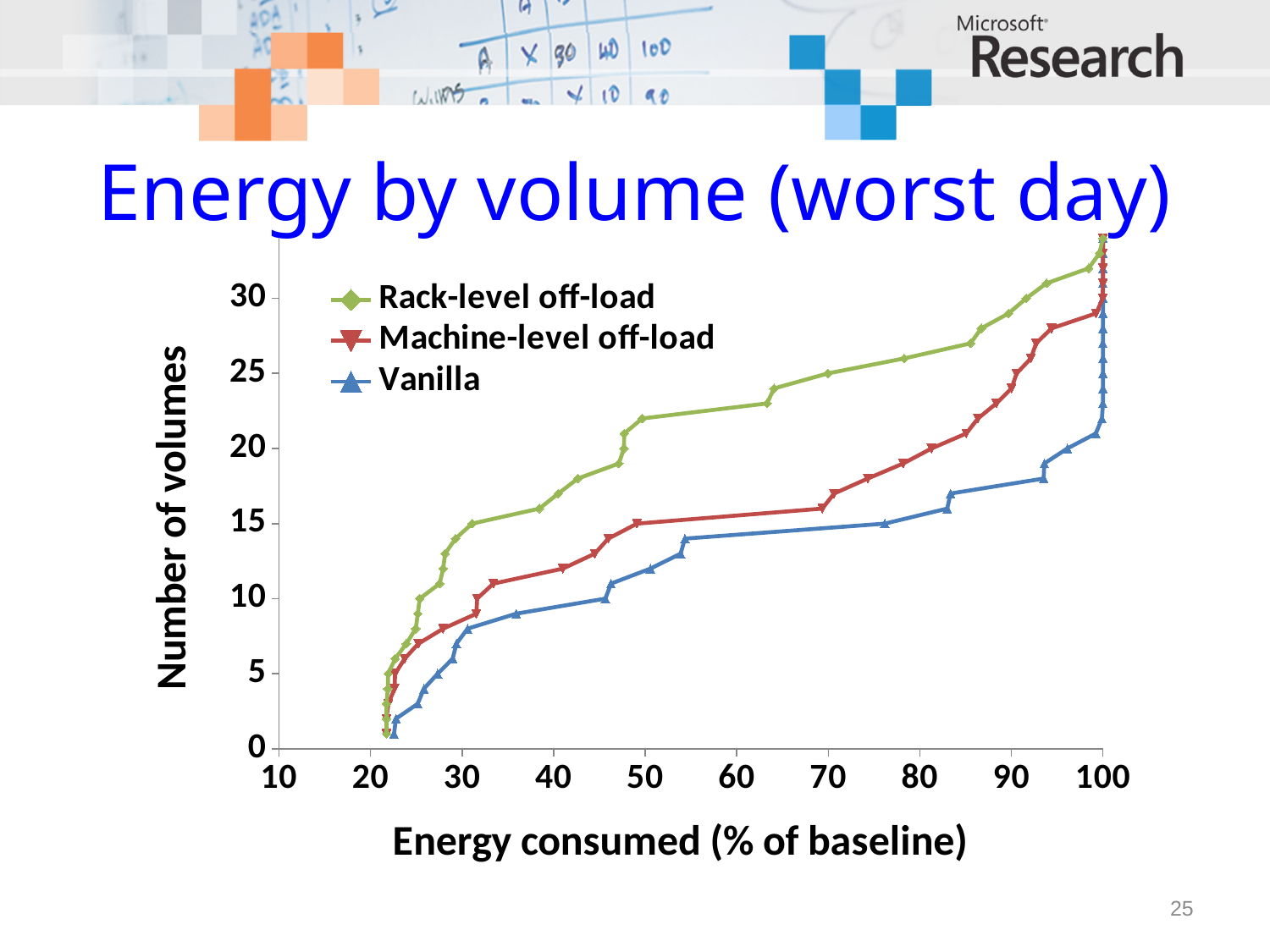
Is the energy consumed for the Rack-level off-load series at 10 volumes greater or less than 30? less Is the energy consumed for the Vanilla series at 20 volumes greater or less than 90? greater Which series reaches 30 volumes at the lowest energy consumed? Rack-level off-load How many series does the legend list? 3 What is the title of the chart? Energy by volume (worst day) At 15 volumes, which series consumes more energy, Vanilla or Rack-level off-load? Vanilla What kind of chart is shown on the slide? line chart What is the label of the x axis? Energy consumed (% of baseline) Does the number of volumes rise or fall as energy consumed increases along the x axis? rise Is the energy consumed for the Rack-level off-load series at 15 volumes greater or less than 40? less